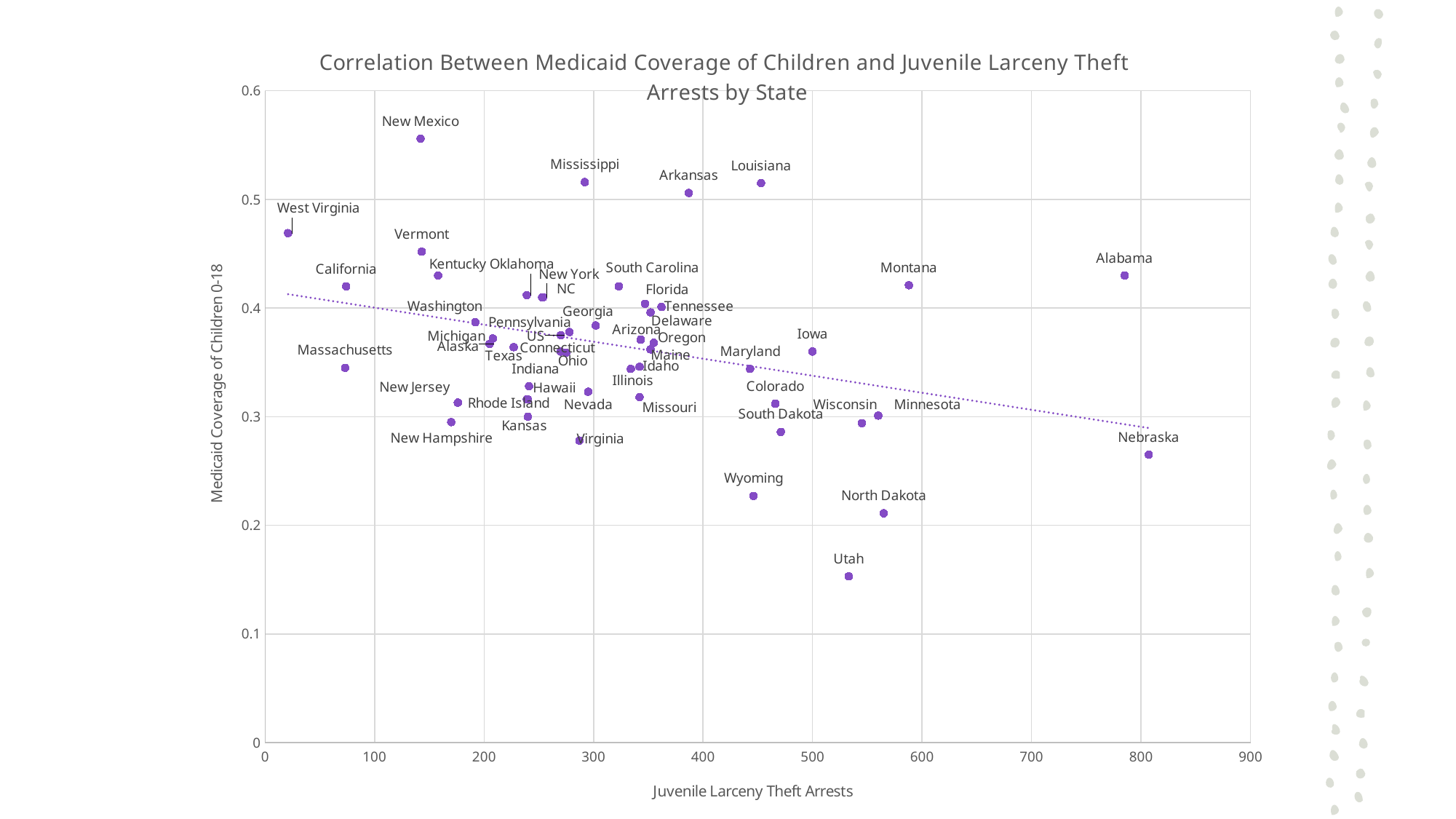
Which state has higher Medicaid coverage of children, Montana or Wyoming? Montana Is the number of juvenile larceny theft arrests for Alabama greater or less than 700? greater What is the title of the x axis? Juvenile Larceny Theft Arrests Which state has the lowest Medicaid coverage of children 0-18? Utah Which state has the highest number of juvenile larceny theft arrests? Nebraska Does the trend line show Medicaid coverage rising or falling as juvenile larceny theft arrests increase? Falling What kind of chart is shown on the slide? Scatter plot Which state has the lowest number of juvenile larceny theft arrests? West Virginia Which state has the highest Medicaid coverage of children 0-18? New Mexico Is the Medicaid coverage value for Wyoming greater or less than 0.3? less Which state has more juvenile larceny theft arrests, Alabama or Nebraska? Nebraska Is the Medicaid coverage value for Mississippi greater or less than 0.5? greater